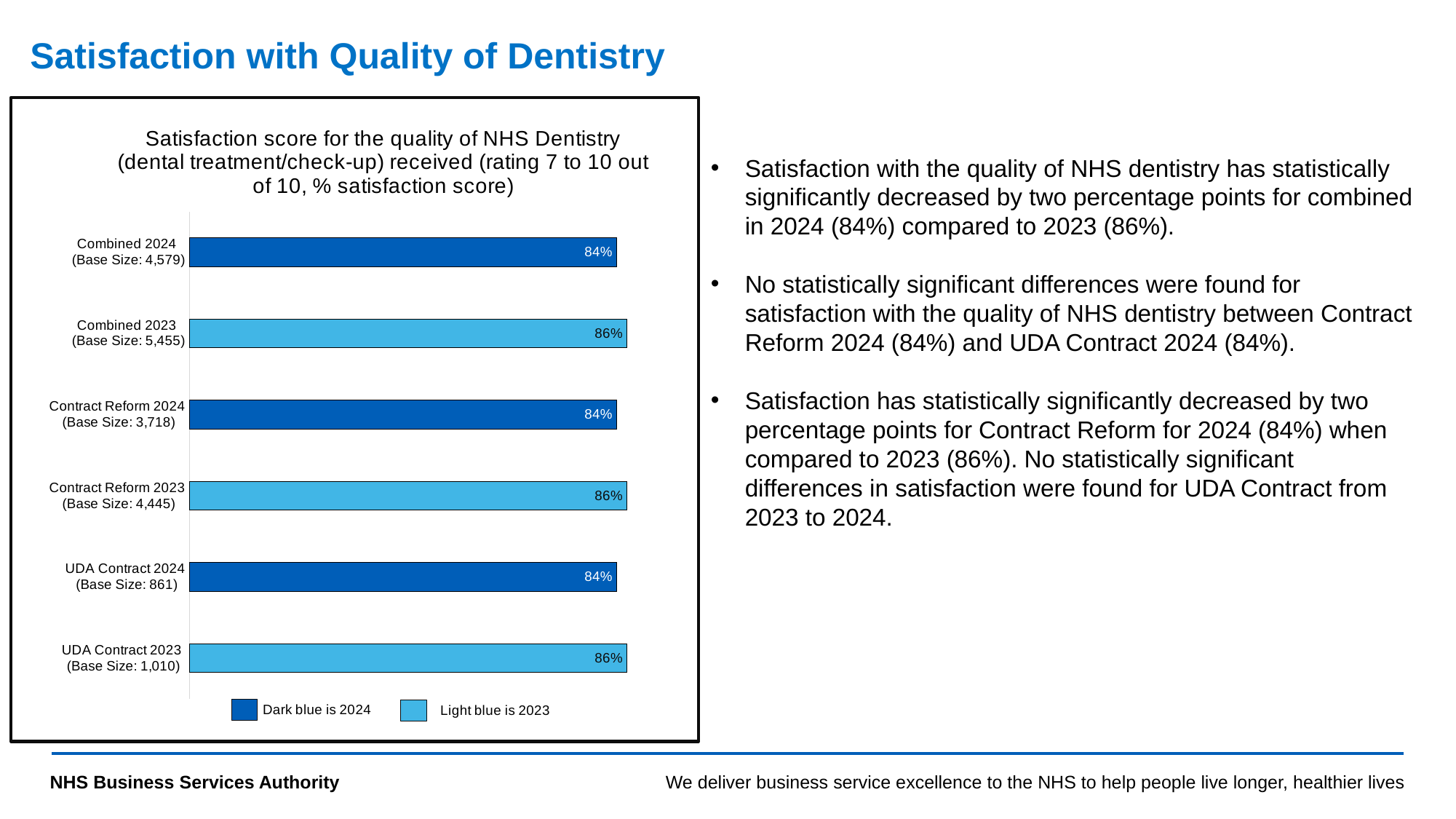
What type of chart is shown on the slide? Bar chart What is the satisfaction score for Combined 2024? 84% Which is larger, the satisfaction score for Contract Reform 2023 or Contract Reform 2024? Contract Reform 2023 What is the difference between the satisfaction scores for Combined 2023 and Combined 2024? 2 percentage points What is the satisfaction score for Combined 2023? 86% What is the difference between the satisfaction scores for UDA Contract 2023 and UDA Contract 2024? 2 percentage points What is the satisfaction score for UDA Contract 2023? 86% According to the legend, which year do the dark blue bars represent? 2024 How many bars are shown in the chart? 6 According to the legend, which year do the light blue bars represent? 2023 What is the base size shown for UDA Contract 2024? 861 What is the satisfaction score for Contract Reform 2024? 84%